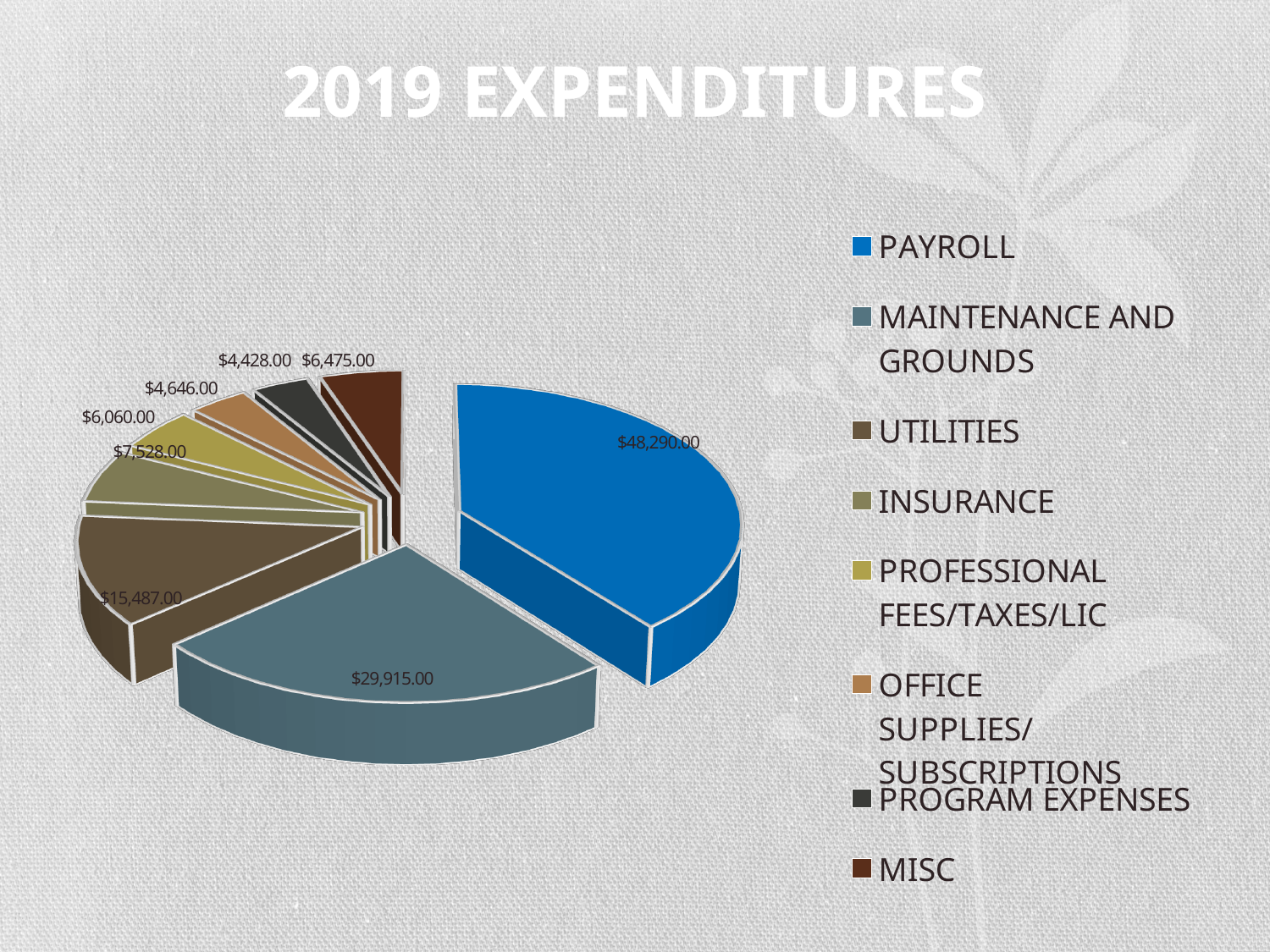
Which category has the largest expenditure? PAYROLL What is the value for PAYROLL? $48,290.00 What colour is the PAYROLL slice? Blue What is the value for MAINTENANCE AND GROUNDS? $29,915.00 Which category has the smallest expenditure? PROGRAM EXPENSES How many categories does the legend list? 8 What is the difference between PAYROLL and MAINTENANCE AND GROUNDS? $18,375.00 What is the value for MISC? $6,475.00 What is the value for UTILITIES? $15,487.00 What is the title of the chart? 2019 EXPENDITURES Which is larger, INSURANCE or PROFESSIONAL FEES/TAXES/LIC? INSURANCE What type of chart is shown on the slide? Pie chart